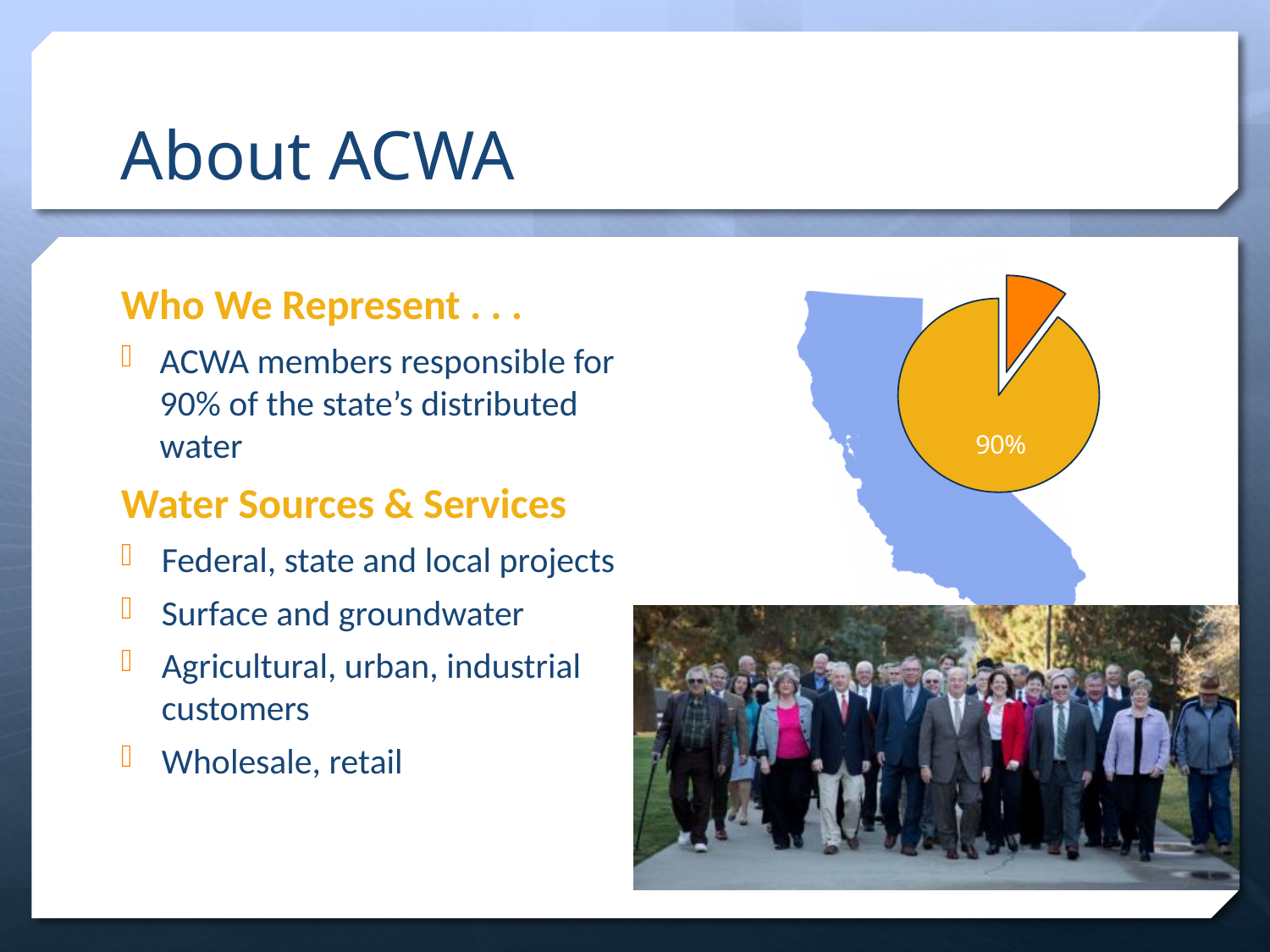
Which slice of the pie chart is larger, the yellow slice or the orange slice? the yellow slice What share of the pie does the large yellow slice represent? 90% How many slices does the pie chart have? 2 What value is printed on the large yellow slice of the pie chart? 90% Which slice is the largest in the pie chart? the yellow slice labeled 90% What colour is the slice that is pulled out (exploded) from the pie chart? orange What kind of chart is shown on the right side of the slide next to the map of California? pie chart Which slice is the smallest in the pie chart? the orange slice Does the pie chart have a legend? No